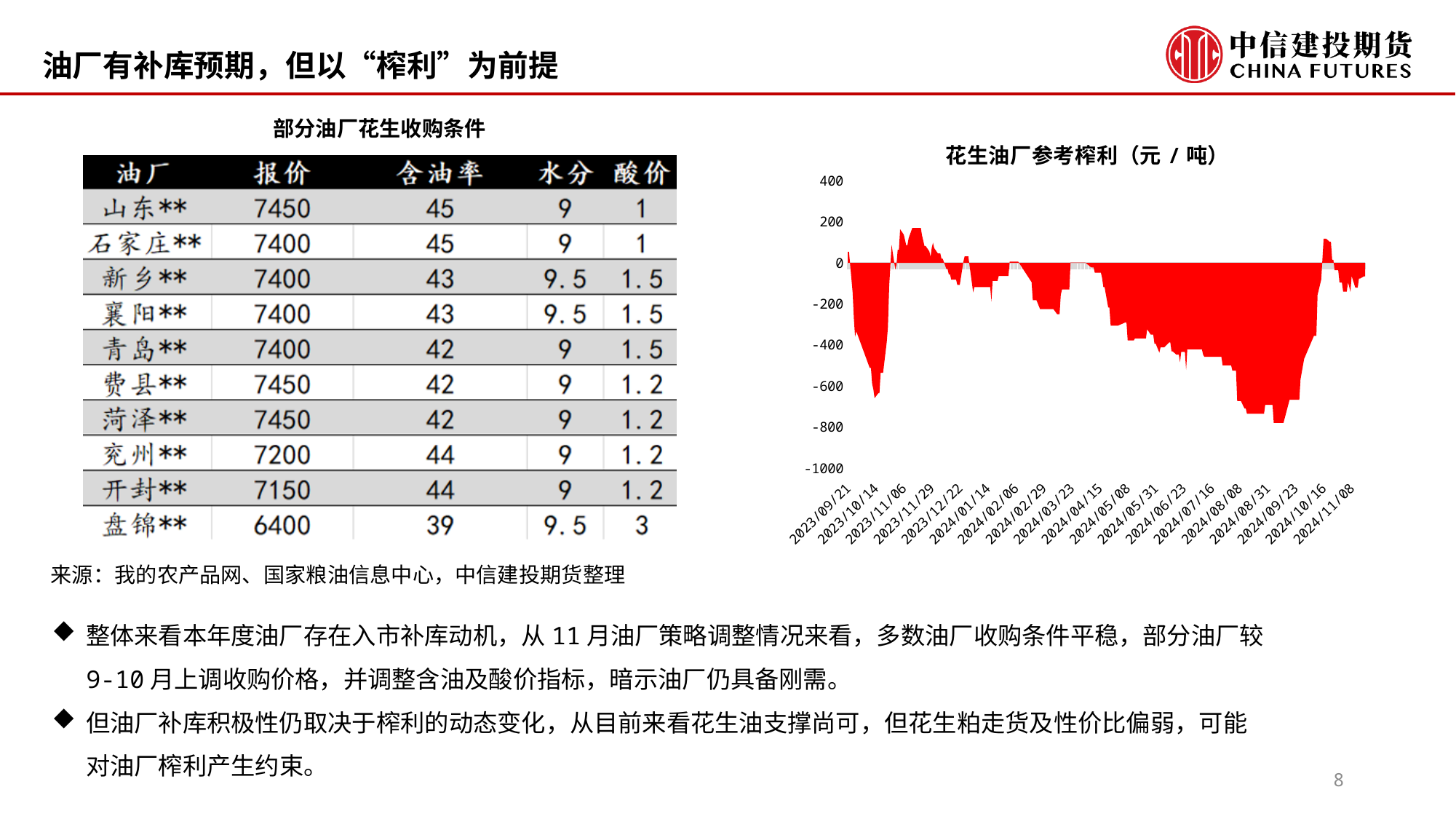
In the 花生油厂参考榨利 chart, which is larger: the value around 2023/10/14 or the value around 2024/02/06? 2024/02/06 In the 花生油厂参考榨利 chart, is the value around 2024/08/08 greater or less than -400? less In the 花生油厂参考榨利 chart, do the values generally rise or fall between 2024/03/23 and 2024/08/08? fall In the 花生油厂参考榨利 chart, is the highest value on the chart greater or less than 0? greater What is the title of the chart on the right side of the slide? 花生油厂参考榨利（元／吨） In the 花生油厂参考榨利 chart, do the values generally rise or fall between 2024/08/31 and 2024/10/16? rise In the 花生油厂参考榨利 chart, is the value around 2023/11/06 greater or less than 0? greater In the 花生油厂参考榨利 chart, which is larger: the value around 2023/11/06 or the value around 2024/08/08? 2023/11/06 What kind of chart is shown on the right side of the slide? area chart What colour is the plotted area in the 花生油厂参考榨利 chart? red